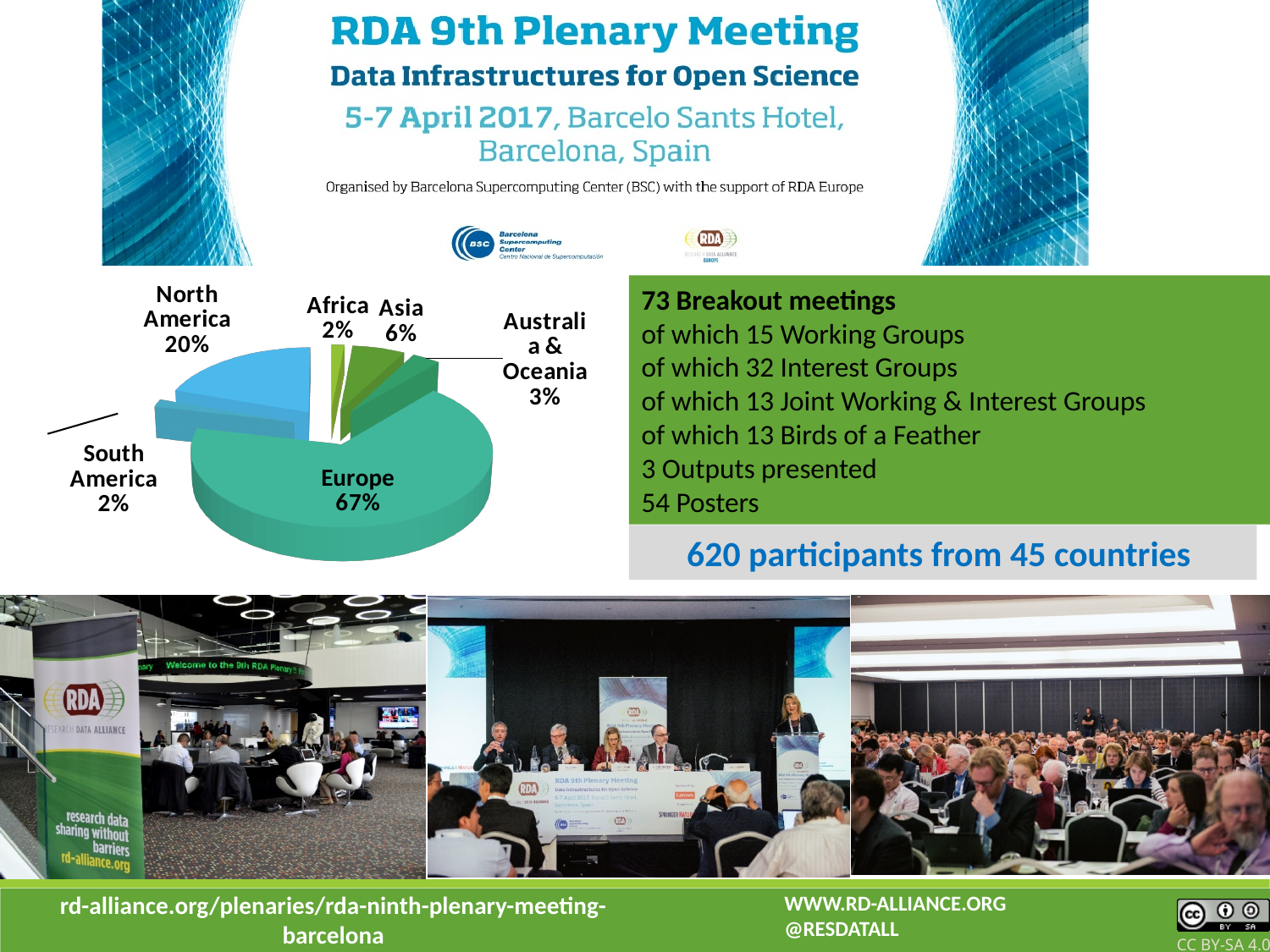
What percentage is shown for Asia in the pie chart? 6% What type of chart is shown on the slide? Pie chart Which region has the smallest share in the pie chart, Asia or Africa? Africa Which is larger in the pie chart, North America or Asia? North America What percentage is shown for North America in the pie chart? 20% Which region has the largest slice of the pie chart? Europe What is the combined share of Africa and South America in the pie chart? 4% How many regions (slices) are shown in the pie chart? 6 Which two regions in the pie chart each have a share of 2%? Africa and South America What percentage is shown for Australia & Oceania in the pie chart? 3% What is the difference in percentage points between Europe and North America in the pie chart? 47 What share of the pie chart does Europe represent? 67%